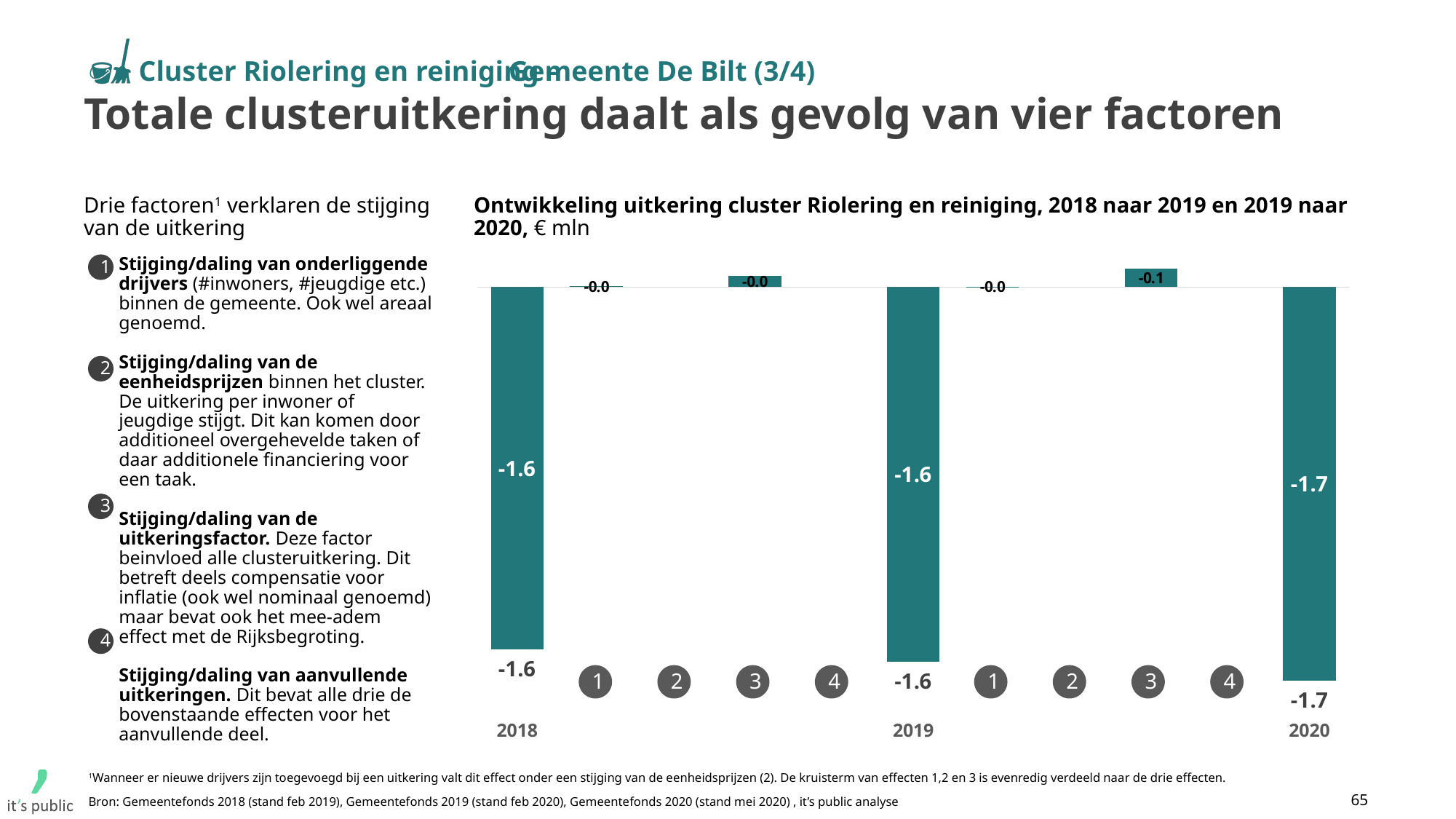
Do the year totals rise or fall from 2018 to 2020? Fall What is the difference between the 2018 value and the 2020 value? 0.1 What is the value labelled for factor 3 in the change from 2019 to 2020? -0.1 What is the value of the cluster payment for 2018? -1.6 What is the value of the cluster payment for 2020? -1.7 Which year has the lower value, 2019 or 2020? 2020 Which year has the lowest total cluster payment value? 2020 What is the value of the cluster payment for 2019? -1.6 What kind of chart is shown on the slide? Bar chart (waterfall) How many year totals (2018, 2019, 2020) are shown in the chart? 3 What is the value labelled for factor 1 in the change from 2019 to 2020? -0.0 In what unit are the values in the chart expressed? € mln